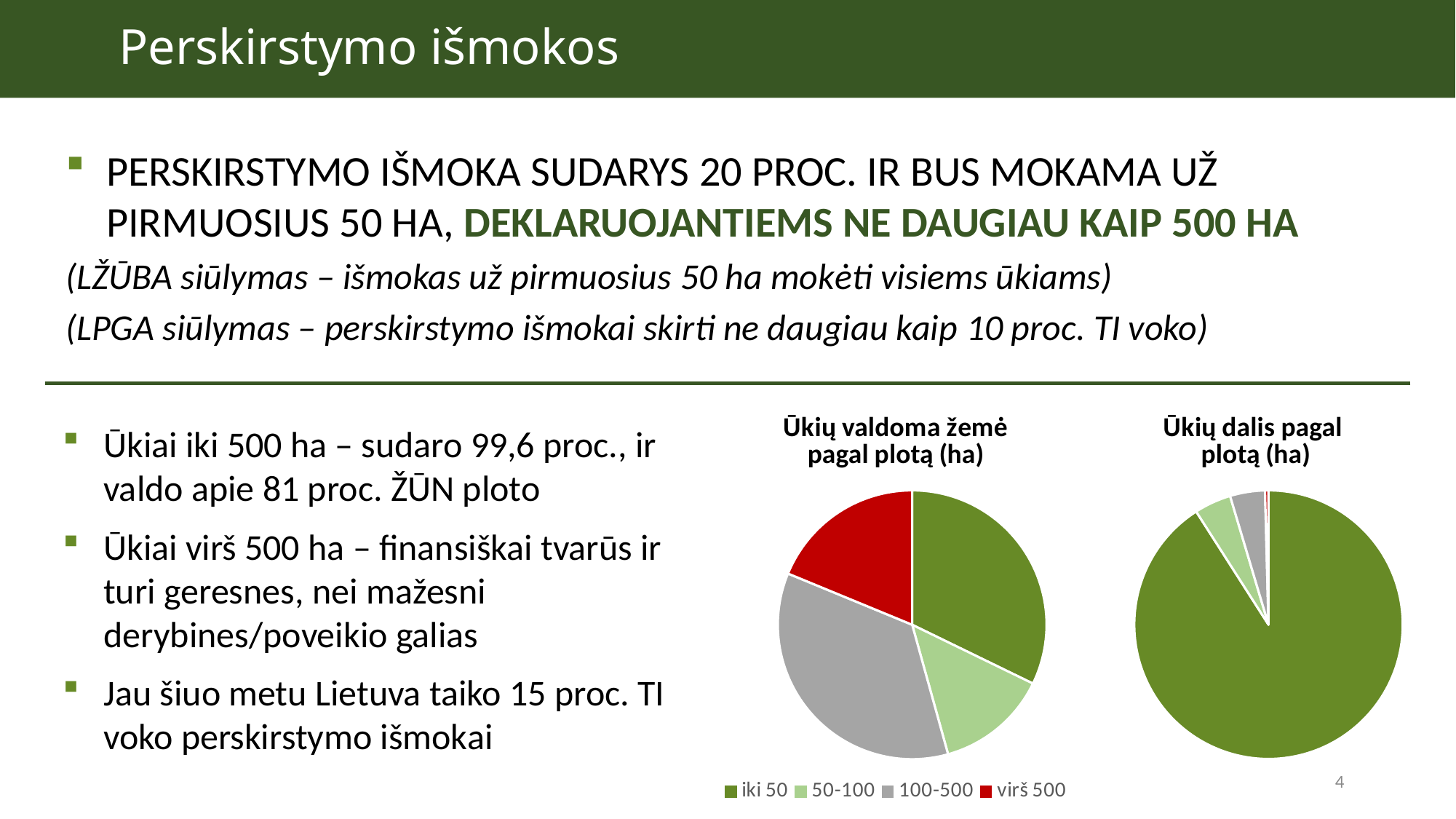
In the chart "Ūkių valdoma žemė pagal plotą (ha)", which category has the largest slice? 100-500 In the chart "Ūkių valdoma žemė pagal plotą (ha)", which category has the smallest slice? 50-100 What kind of chart is "Ūkių dalis pagal plotą (ha)"? pie chart What kind of chart is "Ūkių valdoma žemė pagal plotą (ha)"? pie chart What colour represents the category "virš 500" in the pie charts? red In the chart "Ūkių valdoma žemė pagal plotą (ha)", which slice is larger: 100-500 or 50-100? 100-500 In the chart "Ūkių valdoma žemė pagal plotą (ha)", which slice is larger: iki 50 or virš 500? iki 50 In the chart "Ūkių dalis pagal plotą (ha)", which category has the smallest slice? virš 500 What is the title of the pie chart on the far right of the slide? Ūkių dalis pagal plotą (ha) In the chart "Ūkių dalis pagal plotą (ha)", which category has the largest slice? iki 50 How many categories does the shared legend of the two pie charts list? 4 In the chart "Ūkių dalis pagal plotą (ha)", which slice is larger: iki 50 or 100-500? iki 50